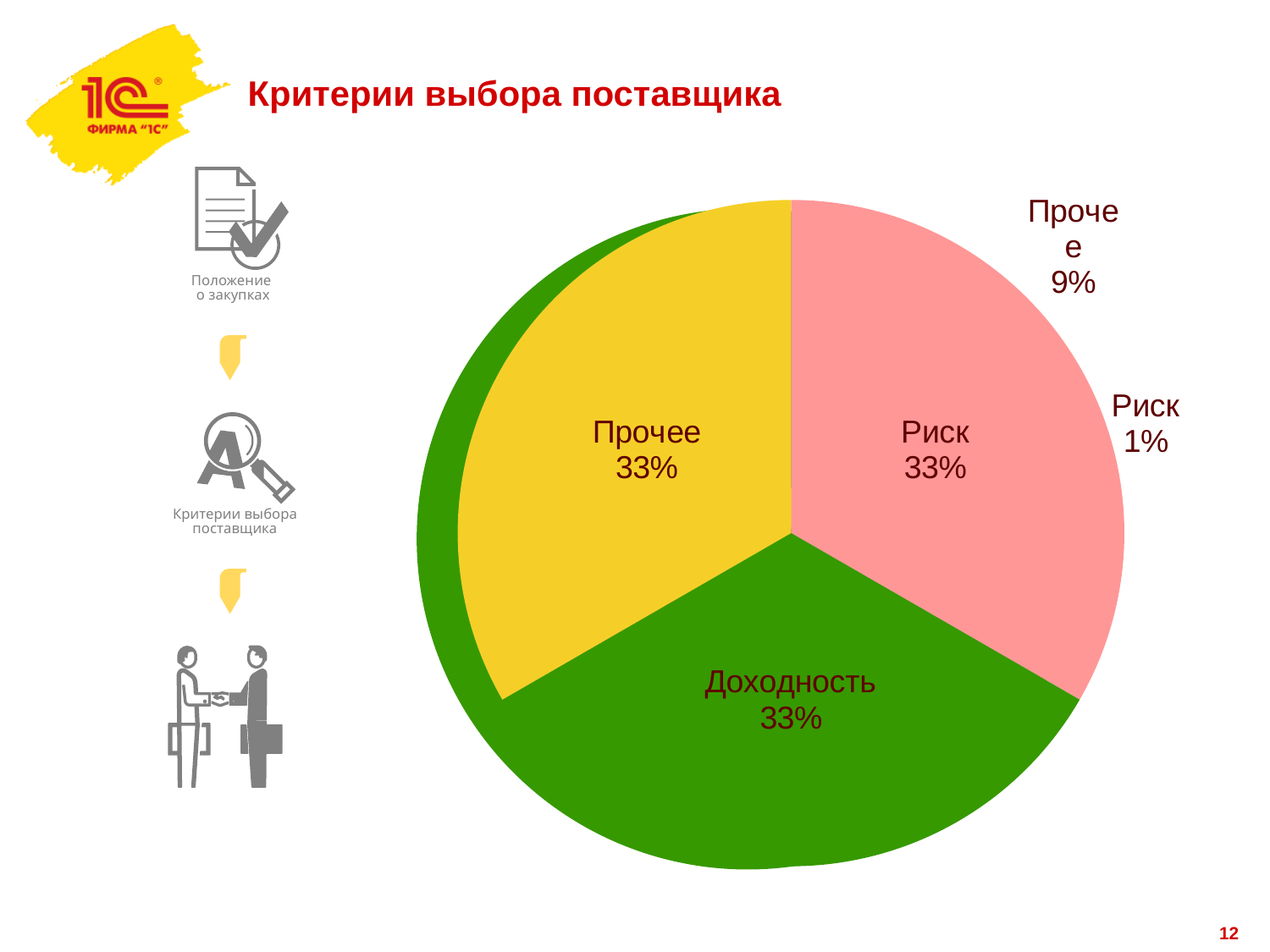
What kind of chart is shown on the slide? pie chart What share of the pie does the Доходность slice represent? 33% Is the share of the Риск slice greater or less than 25%? greater What percentage is shown for the Риск slice inside the pie? 33% What colour is the Доходность slice of the pie chart? green What is the title of the slide containing the pie chart? Критерии выбора поставщика What percentage is shown for the Прочее slice inside the pie? 33% Is the share of the Доходность slice greater or less than 50%? less